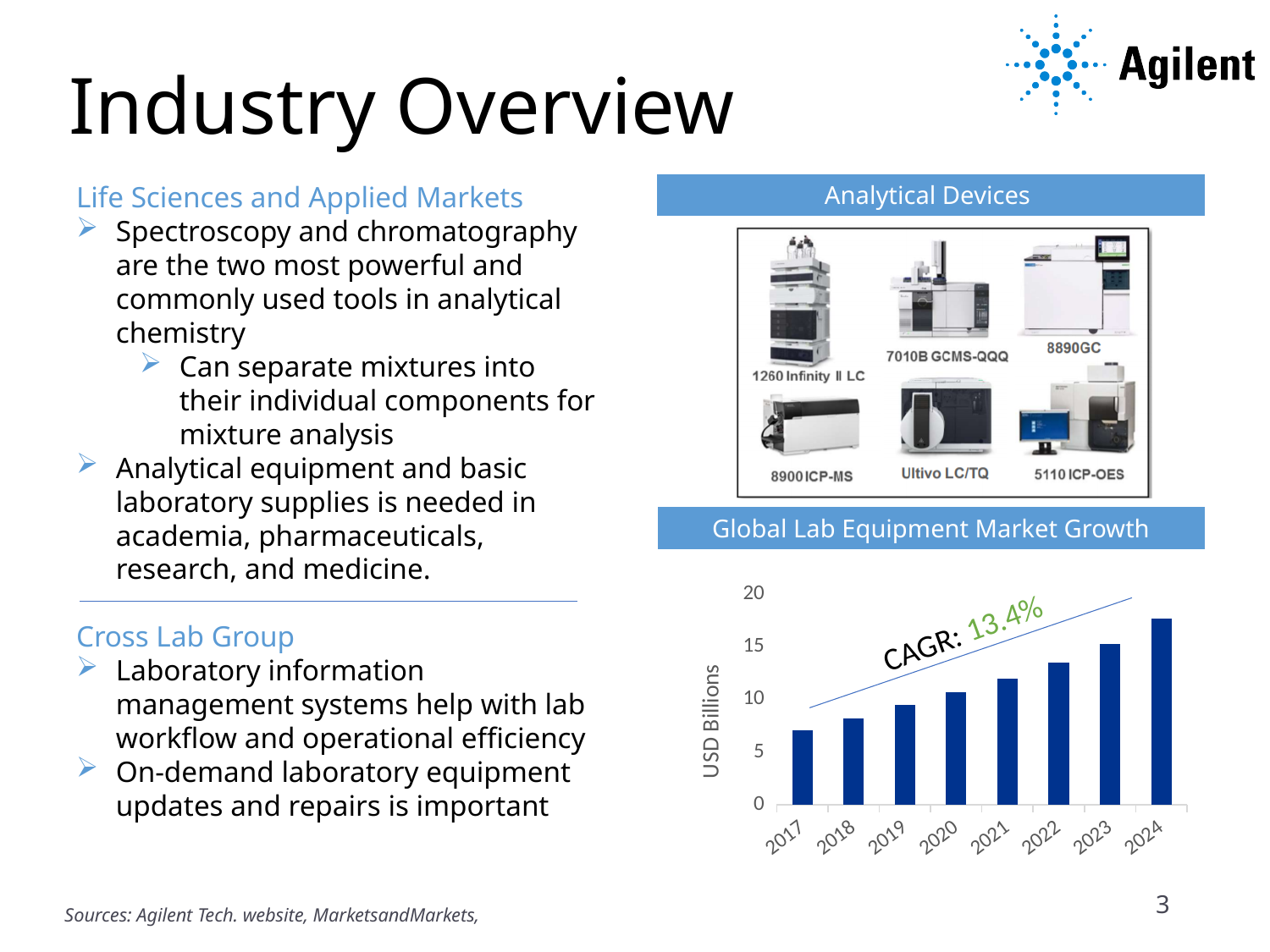
In the Global Lab Equipment Market Growth chart, which is larger, the value for 2019 or the value for 2023? 2023 In the Global Lab Equipment Market Growth chart, do the values rise or fall from 2017 to 2024? rise In the Global Lab Equipment Market Growth chart, is the value for 2017 greater or less than 10? less What is the y-axis label of the Global Lab Equipment Market Growth chart? USD Billions In the Global Lab Equipment Market Growth chart, which year has the highest value? 2024 How many years are plotted in the Global Lab Equipment Market Growth chart? 8 What CAGR is annotated on the Global Lab Equipment Market Growth chart? 13.4% In the Global Lab Equipment Market Growth chart, which year has the lowest value? 2017 In the Global Lab Equipment Market Growth chart, is the value for 2024 greater or less than 15? greater In the Global Lab Equipment Market Growth chart, is the value for 2021 greater or less than 10? greater What kind of chart is shown under 'Global Lab Equipment Market Growth'? bar chart